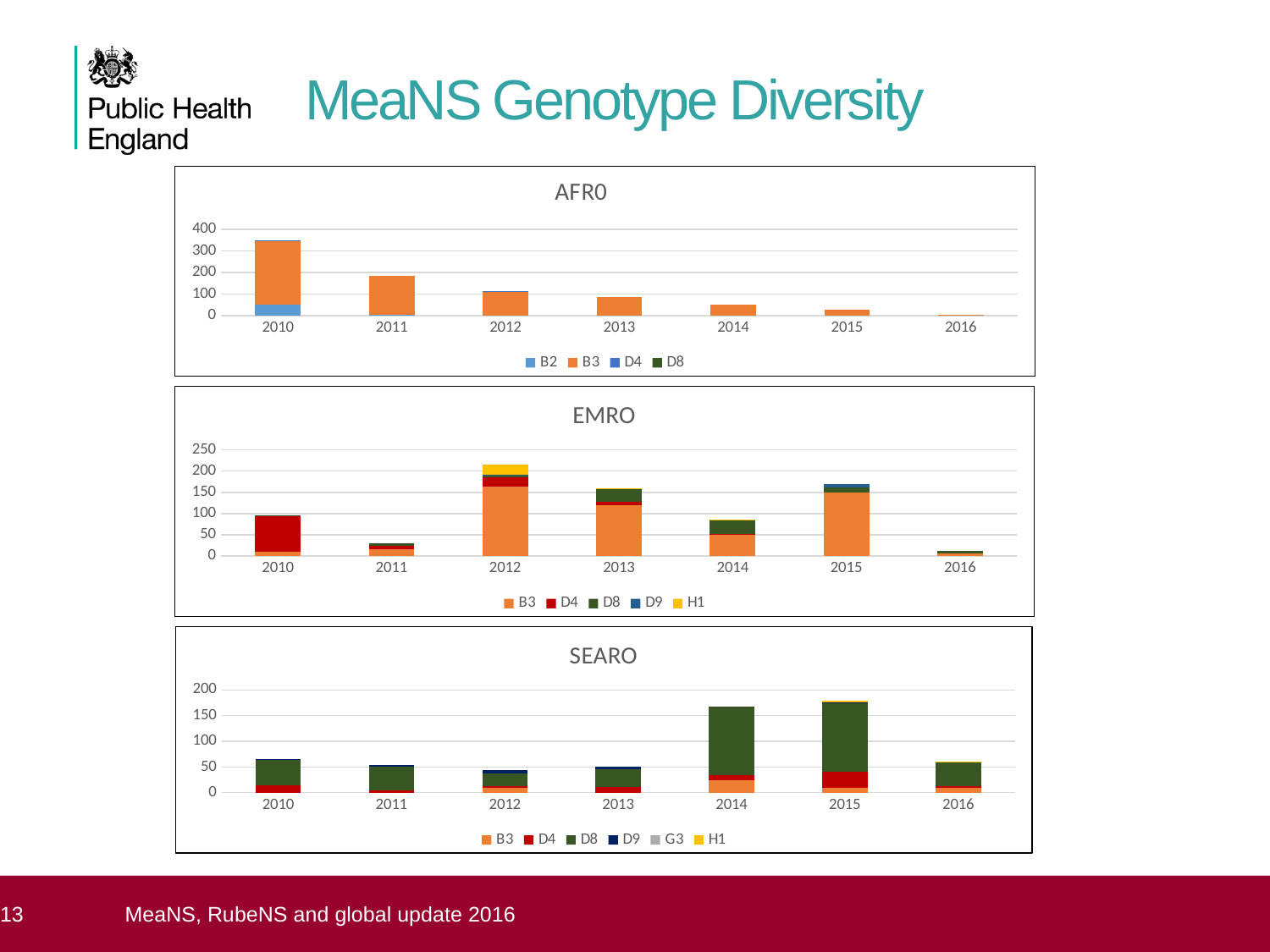
In the EMRO chart, is the total for 2015 greater or less than 150? greater In the AFR0 chart, which year has the lowest total? 2016 In the AFR0 chart, do the totals generally rise or fall from 2010 to 2016? fall In the AFR0 chart, which year has the highest total? 2010 In the SEARO chart, which is larger, the total for 2014 or the total for 2011? 2014 How many years are shown on the x axis of the SEARO chart? 7 How many series does the legend of the AFR0 chart list? 4 How many series does the legend of the EMRO chart list? 5 In the AFR0 chart, is the total for 2011 greater or less than 200? less What type of chart is the AFR0 chart? bar chart In the EMRO chart, which year has the highest total? 2012 In the AFR0 chart, is the total for 2010 greater or less than 300? greater